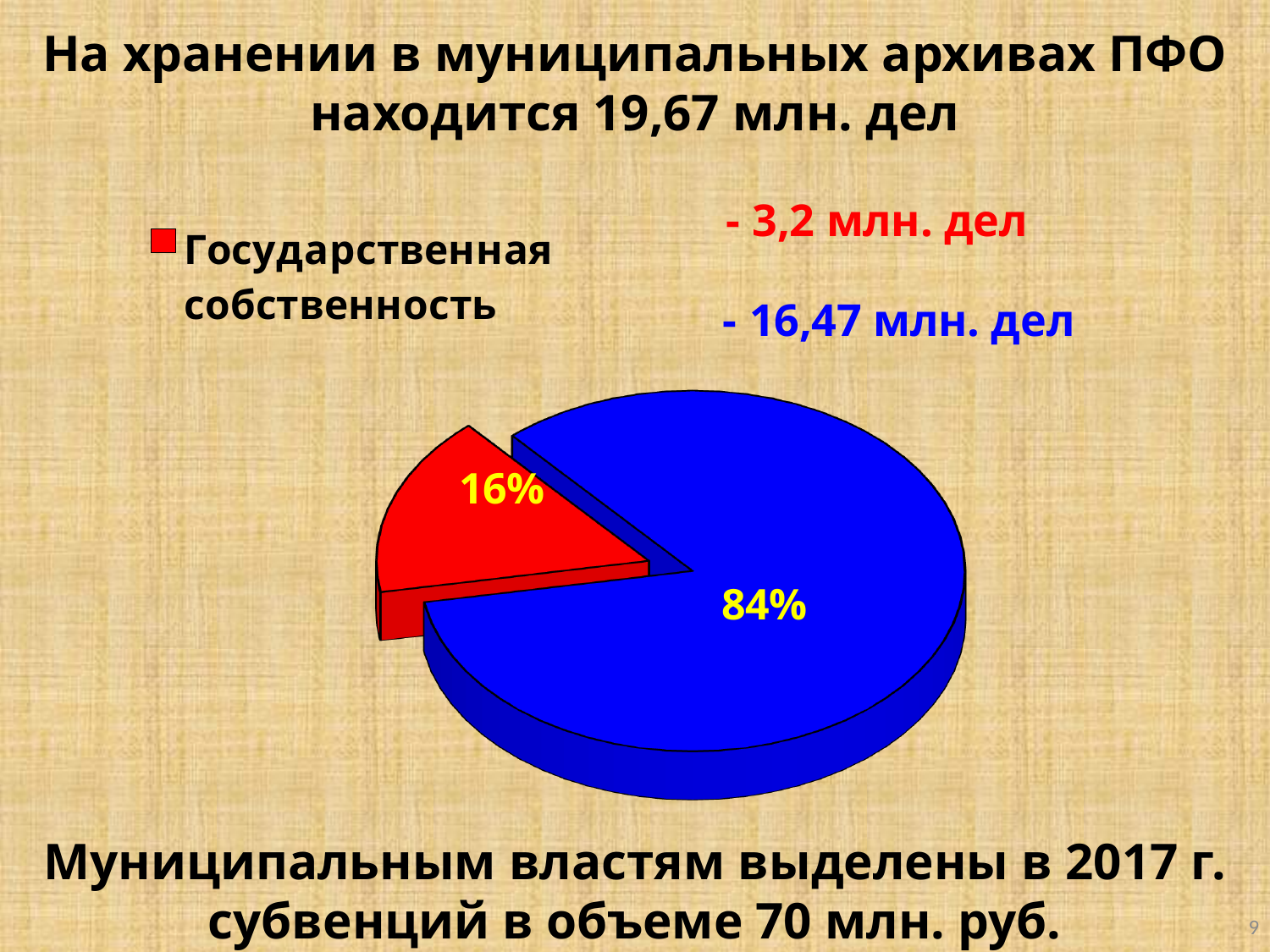
Is the share of the Государственная собственность slice greater or less than 50%? less What colour is the slice for Государственная собственность? Red What share of the pie does the slice for Государственная собственность represent? 16% How many slices does the pie chart have? 2 What share of the pie does the blue slice represent? 84% Which slice of the pie is the smallest? Государственная собственность (16%) Which slice of the pie is the largest? The blue slice (84%) Which is larger: the blue slice or the Государственная собственность slice? The blue slice What kind of chart is shown on the slide? Pie chart What is the only entry listed in the chart's legend? Государственная собственность What is the difference in percentage points between the blue slice and the Государственная собственность slice? 68 percentage points How many entries does the legend list? 1